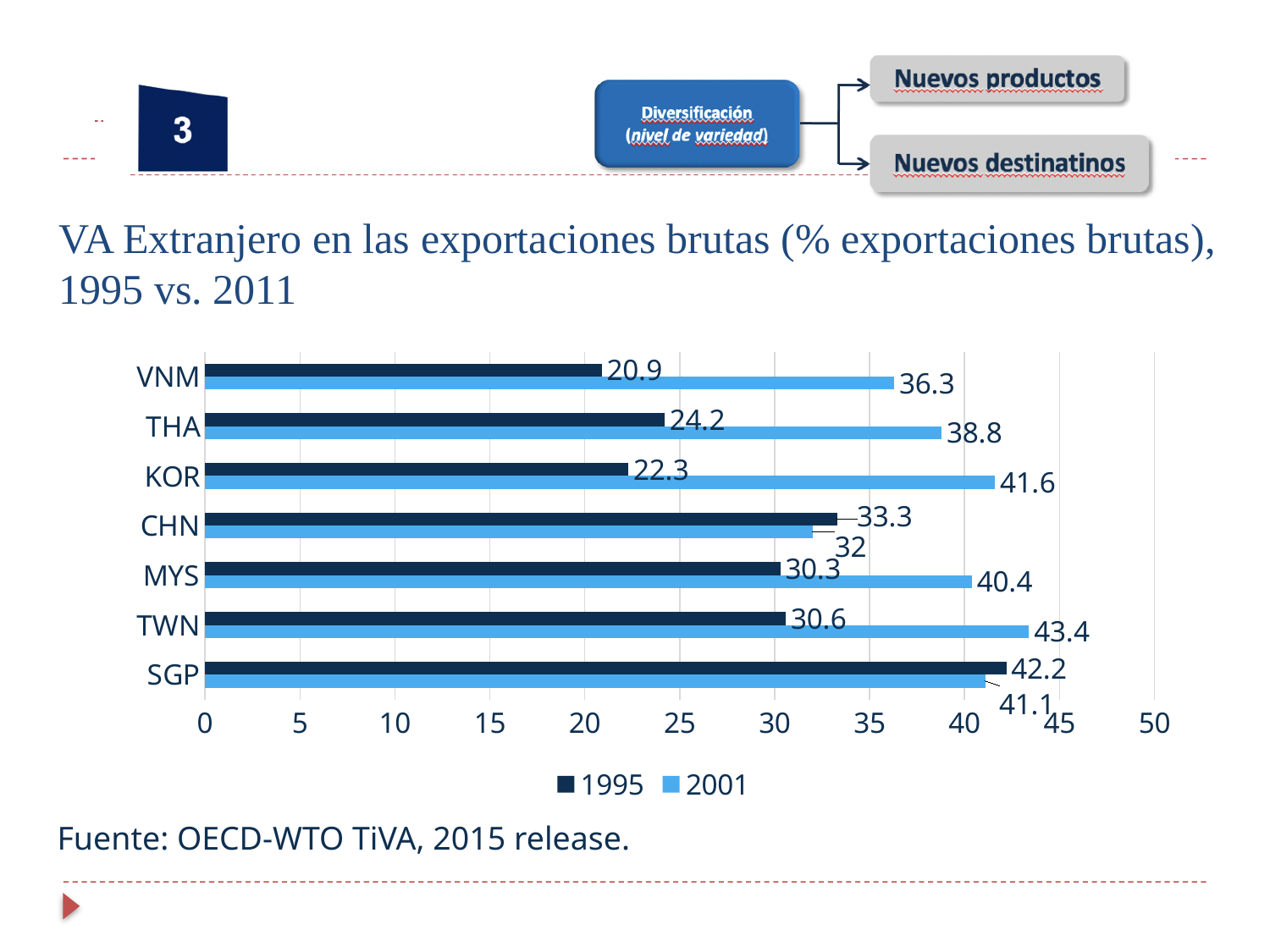
Which country has the highest 1995 value? SGP What is the difference between the 2001 and 1995 values for THA? 14.6 What is the 2001 value for KOR? 41.6 How many series does the legend list? 2 For CHN, which is larger, the 1995 value or the 2001 value? 1995 Which country has the highest 2001 value? TWN What kind of chart is shown? bar chart How many countries are shown on the chart? 7 What is the 1995 value for VNM? 20.9 Which country has the lowest 1995 value? VNM What is the 2001 value for CHN? 32 What are the two series named in the legend? 1995 and 2001